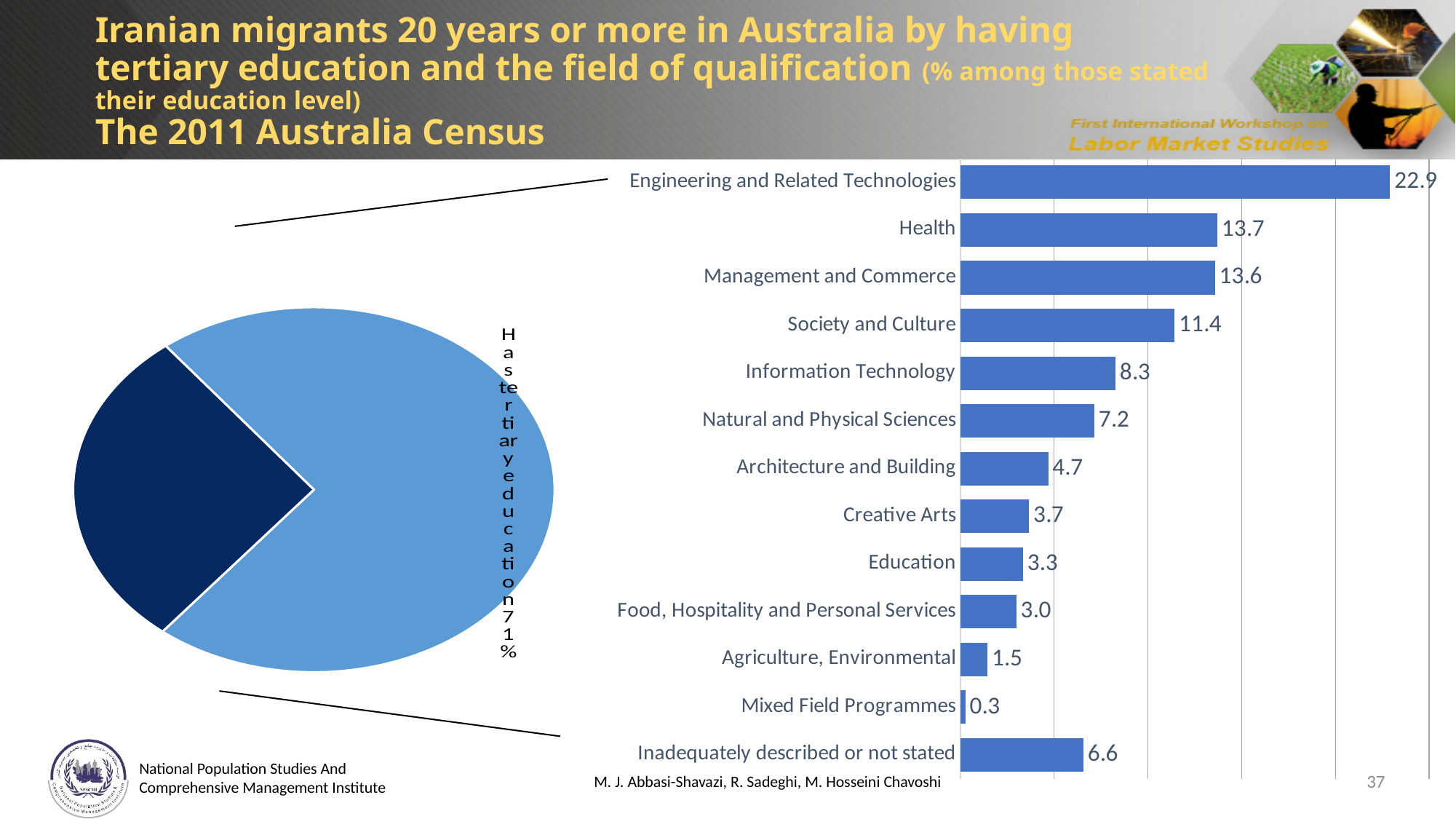
On the bar chart on the right, which is larger: Architecture and Building or Creative Arts? Architecture and Building What kind of chart is the chart on the right of the slide? Bar chart On the bar chart on the right, which field has the highest value? Engineering and Related Technologies On the bar chart on the right, what is the difference between Information Technology and Natural and Physical Sciences? 1.1 How many categories are shown on the bar chart on the right? 13 What kind of chart is the chart on the left of the slide? Pie chart On the bar chart on the right, what is the value for Engineering and Related Technologies? 22.9 On the bar chart on the right, what is the difference between Engineering and Related Technologies and Health? 9.2 On the pie chart on the left, what share is labelled for 'Has tertiary education'? 71% On the bar chart on the right, what is the value for Food, Hospitality and Personal Services? 3.0 On the bar chart on the right, which field has the lowest value? Mixed Field Programmes On the bar chart on the right, what is the value for Society and Culture? 11.4